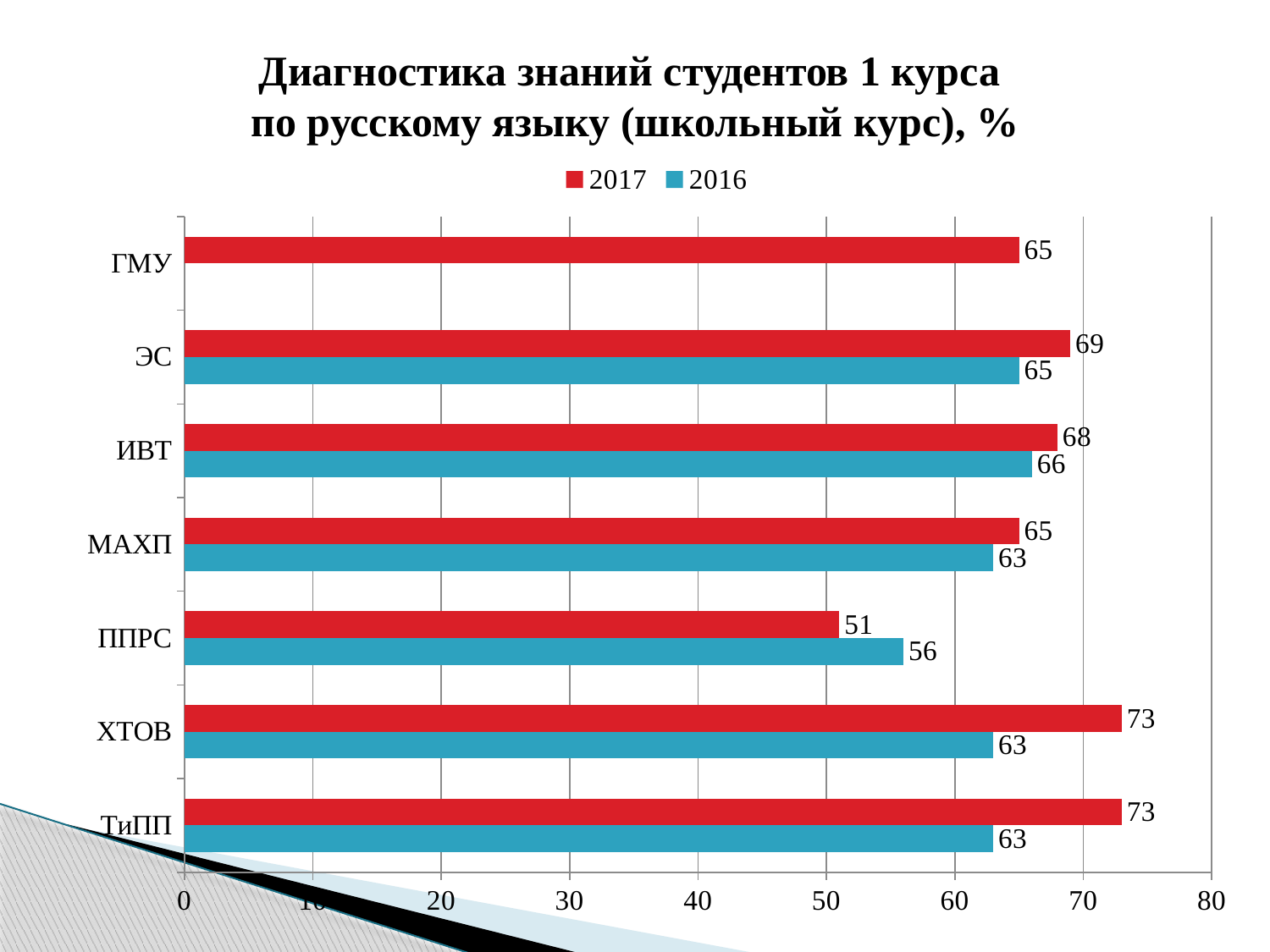
What kind of chart is shown on the slide? bar chart How many series does the legend list? 2 How many categories are shown on the chart? 7 What is the 2017 value for ХТОВ? 73 What is the 2017 value for ППРС? 51 What is the difference between the 2016 and 2017 values for ППРС? 5 Which category has the lowest 2017 value? ППРС What is the difference between the 2017 and 2016 values for ХТОВ? 10 Which is larger for ИВТ, the 2017 value or the 2016 value? 2017 What is the 2016 value for ЭС? 65 Which category has the lowest 2016 value? ППРС Which category has the highest 2016 value? ИВТ